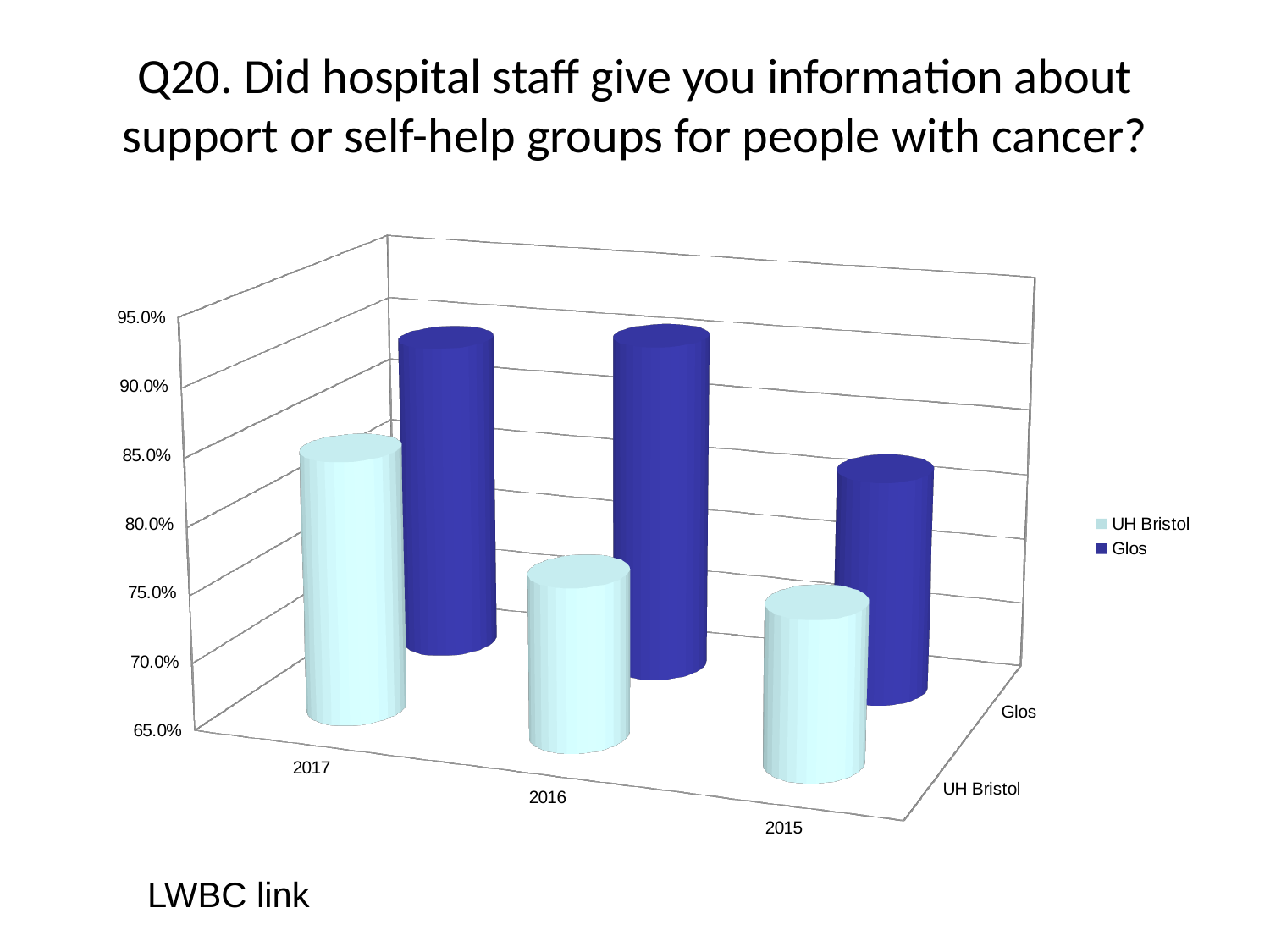
How many year categories are plotted along the x axis? 3 Is the value for Glos in 2015 greater or less than 90.0%? less What kind of chart is shown on the slide? bar chart Is the value for UH Bristol in 2017 greater or less than 75.0%? greater How many series does the legend list? 2 In 2015, which series has the larger value, UH Bristol or Glos? Glos Which series does the legend list first? UH Bristol Is the value for Glos in 2017 greater or less than 85.0%? greater For the UH Bristol series, which year has the highest value? 2017 In 2017, which series has the larger value, UH Bristol or Glos? Glos For the Glos series, which year has the lowest value? 2015